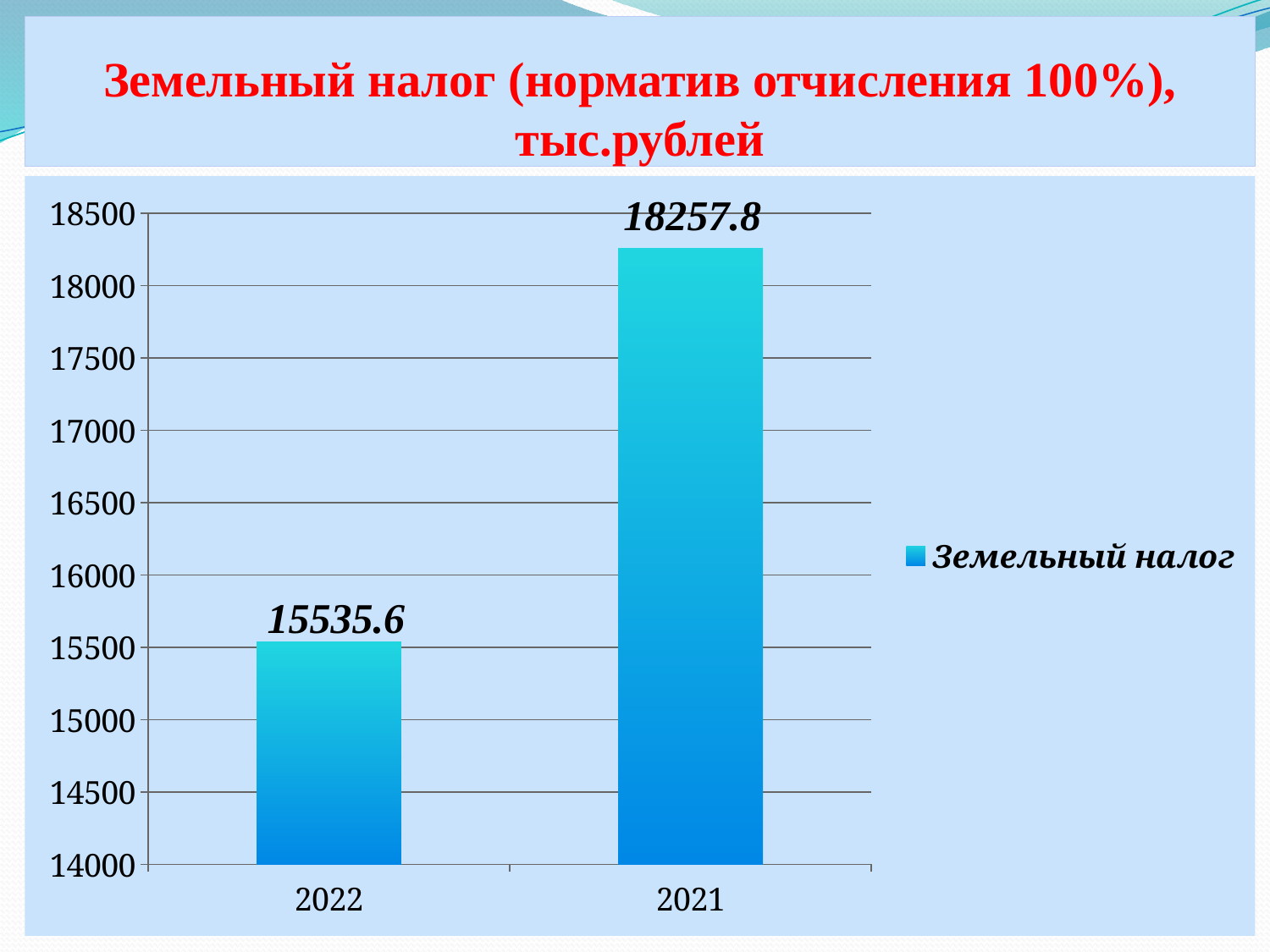
Is the value for 2022 greater or less than 16000? less Which year has the lowest value? 2022 How many categories are shown on the x axis? 2 Which year has the highest value? 2021 How many series does the legend list? 1 What is the value for 2021? 18257.8 What is the value for 2022? 15535.6 What is the difference between the values for 2021 and 2022? 2722.2 Which is larger, the value for 2022 or the value for 2021? 2021 What is the legend entry for the series? Земельный налог What kind of chart is shown? bar chart Is the value for 2021 greater or less than 18000? greater